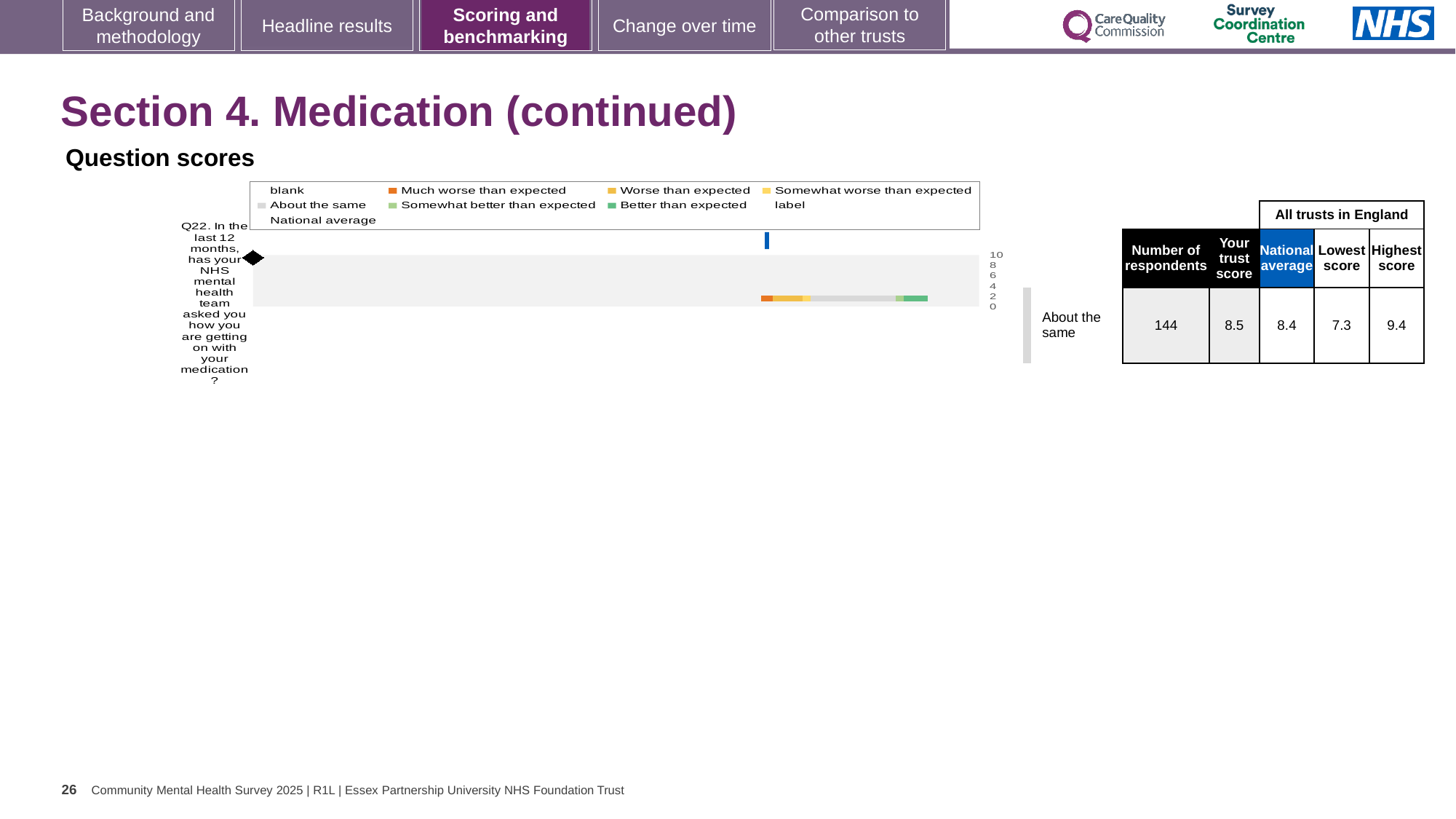
What is the highest score among all trusts in England for Q22? 9.4 What is the number of respondents for Q22? 144 What benchmark category is shown next to the chart for Q22? About the same What is the highest value shown on the chart's axis? 10 What is the lowest score among all trusts in England for Q22? 7.3 What is the national average for Q22? 8.4 What is the trust score for Q22? 8.5 Which legend entry is shown in orange? Much worse than expected Which question number is plotted on the chart? Q22 Is the trust score for Q22 higher or lower than the national average? higher What kind of chart is shown on the slide? bar chart How many questions are plotted on the chart? 1